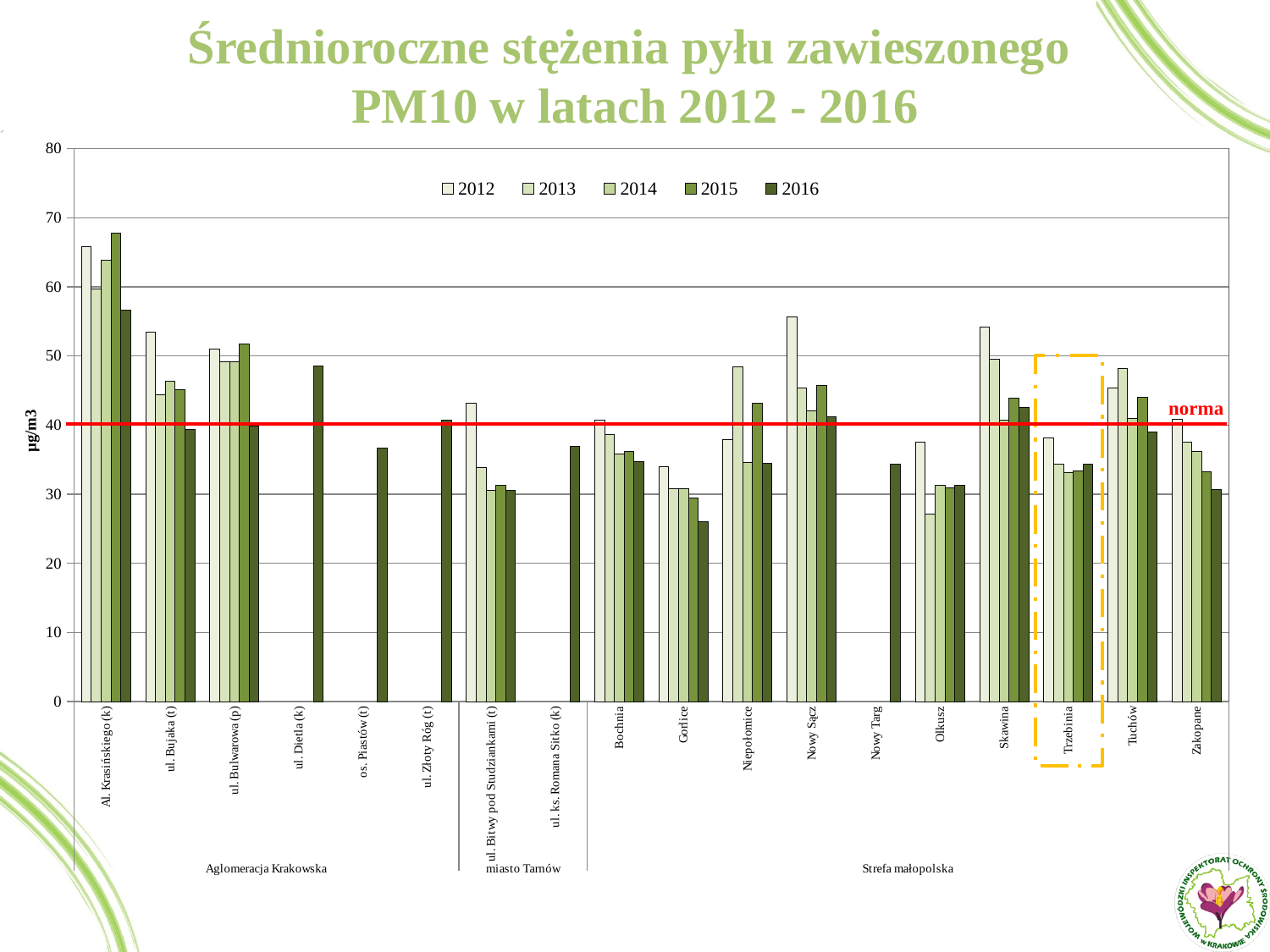
Is the 2016 value for Gorlice greater or less than 30? less Is the 2016 value for Al. Krasińskiego (k) greater or less than 50? greater What is the label of the red horizontal line at 40 µg/m3? norma How many measurement stations (categories) are shown on the x axis? 18 Is the 2013 value for Olkusz greater or less than 30? less Do the values for Zakopane rise or fall from 2012 to 2016? fall How many series does the legend list? 5 Which is larger for Al. Krasińskiego (k): the 2012 value or the 2016 value? 2012 Which station has the highest 2016 value? Al. Krasińskiego (k) What kind of chart is shown on the slide? bar chart